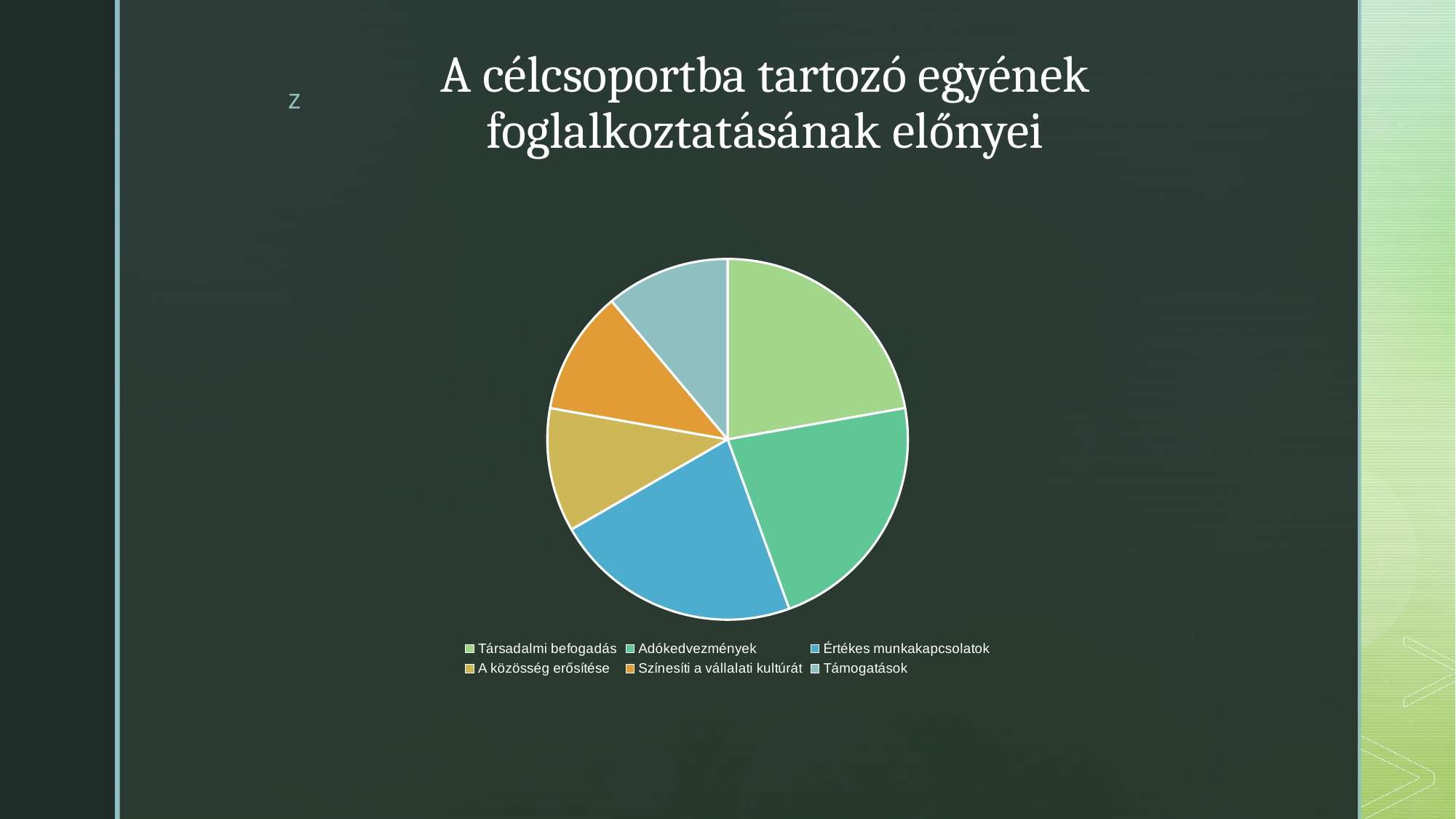
Which slice is larger: Értékes munkakapcsolatok or Támogatások? Értékes munkakapcsolatok Which legend entry is shown in orange on the pie chart? Színesíti a vállalati kultúrát Which slice is larger: Társadalmi befogadás or A közösség erősítése? Társadalmi befogadás What is the title of the slide containing the pie chart? A célcsoportba tartozó egyének foglalkoztatásának előnyei How many slices does the pie chart have? 6 Which slice is larger: Támogatások or Adókedvezmények? Adókedvezmények What kind of chart is shown on the slide? pie chart How many entries does the legend of the pie chart list? 6